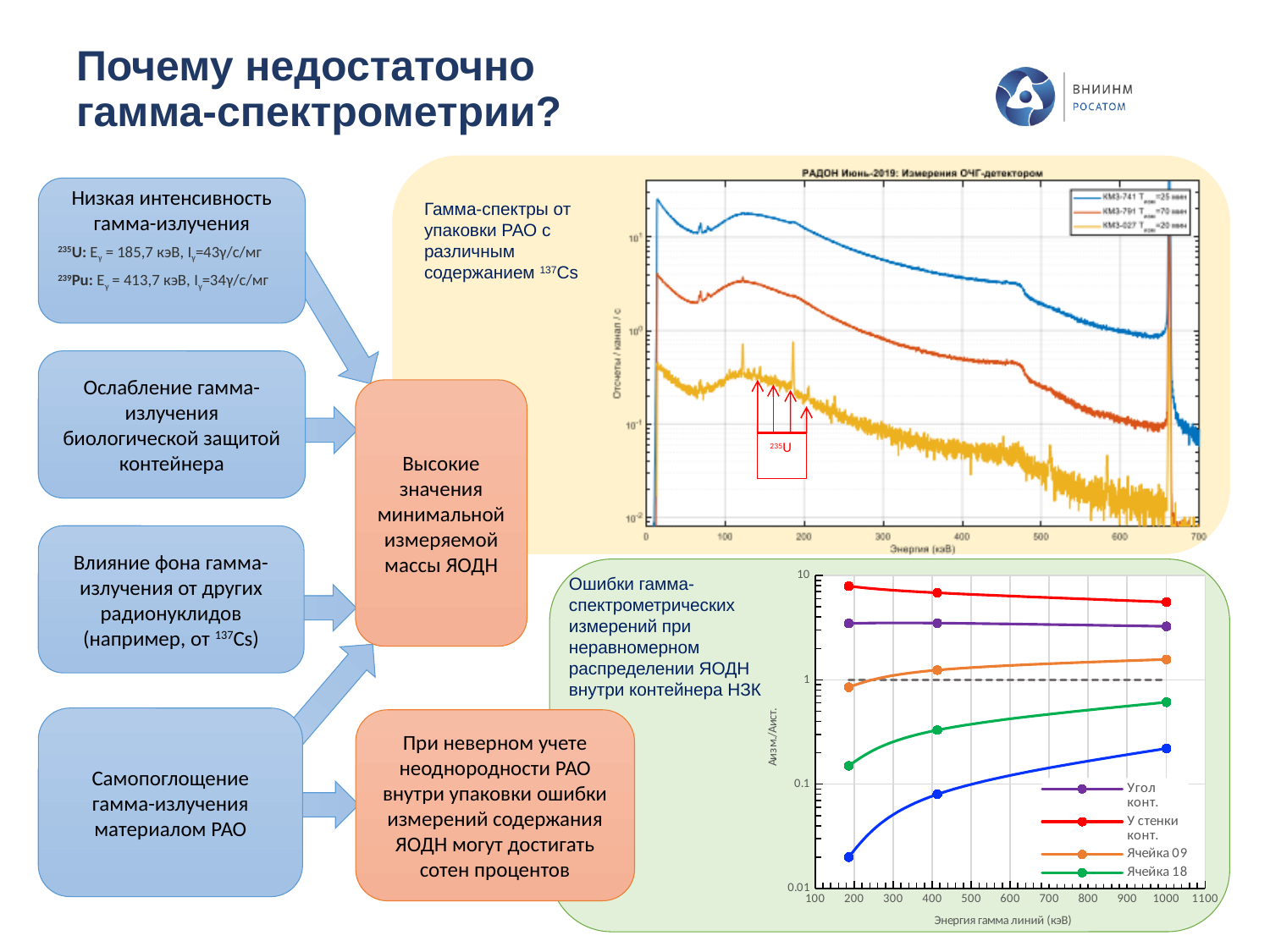
What kind of chart is the bottom chart (Ошибки гамма-спектрометрических измерений)? line chart In the bottom chart, do the values for 'Ячейка 18' rise or fall as the gamma line energy increases? rise In the bottom chart, at about 1000 keV, which is larger: the value for 'Ячейка 09' or for 'Ячейка 18'? Ячейка 09 In the bottom chart, do the values for 'У стенки конт.' rise or fall as the gamma line energy increases? fall In the bottom chart, which legend series has the highest values? У стенки конт. In the bottom chart, how many series does the legend list? 4 In the bottom chart, which legend series has the lowest values? Ячейка 18 What is the x-axis label of the bottom chart? Энергия гамма линий (кэВ) In the top chart (РАДОН Июнь-2019), how many series does the legend list? 3 In the bottom chart, is the value for 'Ячейка 18' at about 1000 keV greater or less than 1? less In the bottom chart, is the value for 'У стенки конт.' at about 1000 keV greater or less than 1? greater In the bottom chart, how many data points are plotted for the series 'Ячейка 18'? 3